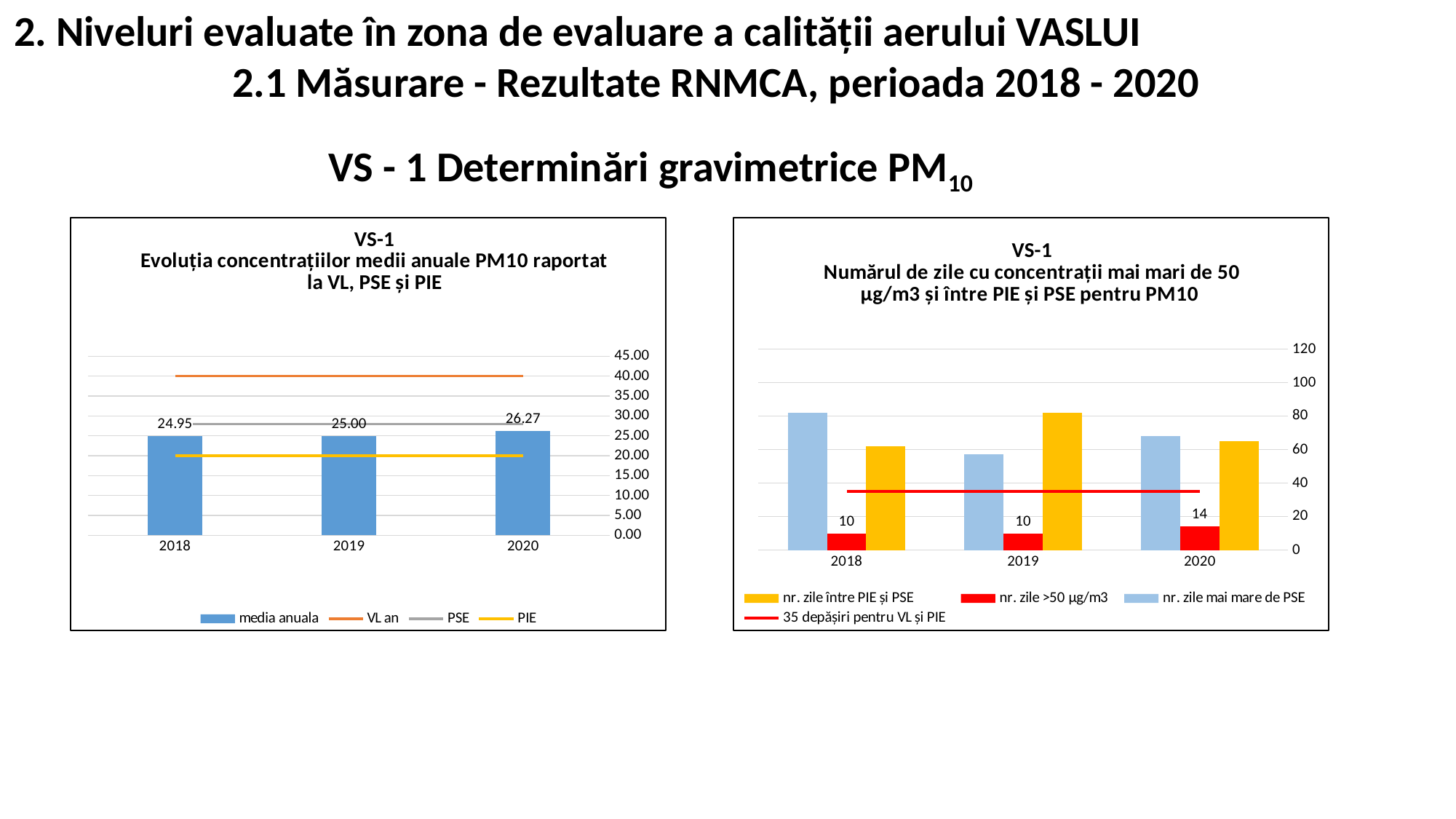
In the left chart (Evoluția concentrațiilor medii anuale PM10), what is the media anuala value for 2020? 26.27 In the left chart (Evoluția concentrațiilor medii anuale PM10), what is the difference between the media anuala for 2020 and 2019? 1.27 In the right chart (Numărul de zile cu concentrații mai mari de 50 µg/m3), which year has the highest nr. zile >50 µg/m3? 2020 In the right chart (Numărul de zile cu concentrații mai mari de 50 µg/m3), which is larger for 2019: nr. zile între PIE și PSE or nr. zile mai mare de PSE? nr. zile între PIE și PSE In the left chart (Evoluția concentrațiilor medii anuale PM10), which year has the highest media anuala? 2020 In the left chart (Evoluția concentrațiilor medii anuale PM10), what is the media anuala value for 2018? 24.95 In the left chart (Evoluția concentrațiilor medii anuale PM10), how many series does the legend list? 4 In the right chart (Numărul de zile cu concentrații mai mari de 50 µg/m3), what is the value of nr. zile >50 µg/m3 for 2018? 10 In the right chart (Numărul de zile cu concentrații mai mari de 50 µg/m3), is the value of nr. zile mai mare de PSE for 2018 greater or less than 60? greater In the right chart (Numărul de zile cu concentrații mai mari de 50 µg/m3), what is the value of nr. zile >50 µg/m3 for 2020? 14 What kind of chart is the right chart (Numărul de zile cu concentrații mai mari de 50 µg/m3)? combination bar and line chart In the left chart (Evoluția concentrațiilor medii anuale PM10), is the VL an line greater or less than 35.00? greater